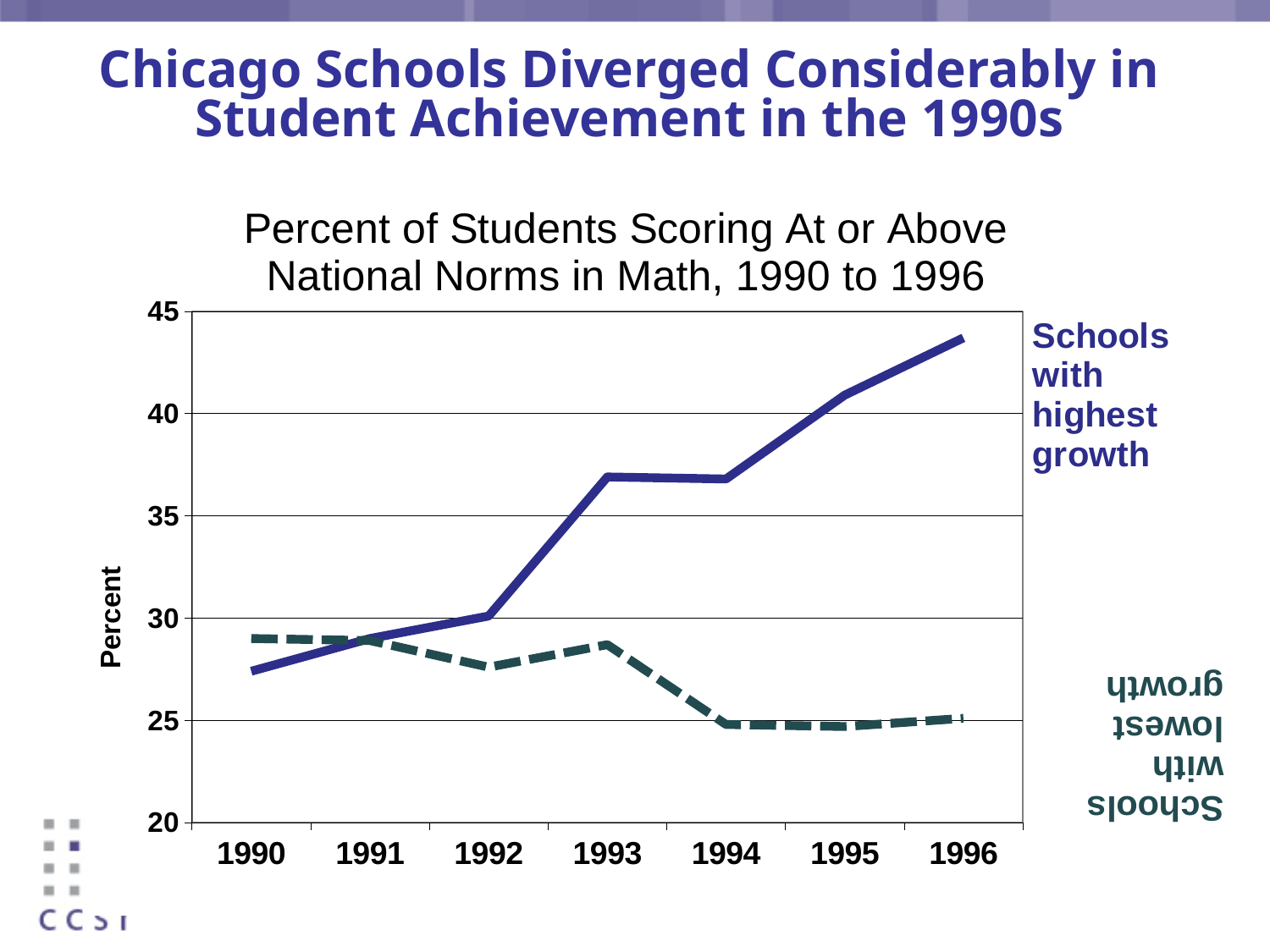
Is the value for Schools with highest growth in 1996 greater or less than 40? greater What is the label on the y axis of the chart? Percent How many lines (series) are plotted on the chart? 2 Is the value for Schools with lowest growth in 1994 greater or less than 30? less How many years are plotted along the x axis? 7 In which year is the value for Schools with highest growth the highest? 1996 Is the value for Schools with highest growth in 1990 greater or less than 30? less In 1996, which series has the larger value: Schools with highest growth or Schools with lowest growth? Schools with highest growth What kind of chart is shown on the slide? line chart Does the line for Schools with highest growth rise or fall from 1990 to 1996? rise In which year is the value for Schools with highest growth the lowest? 1990